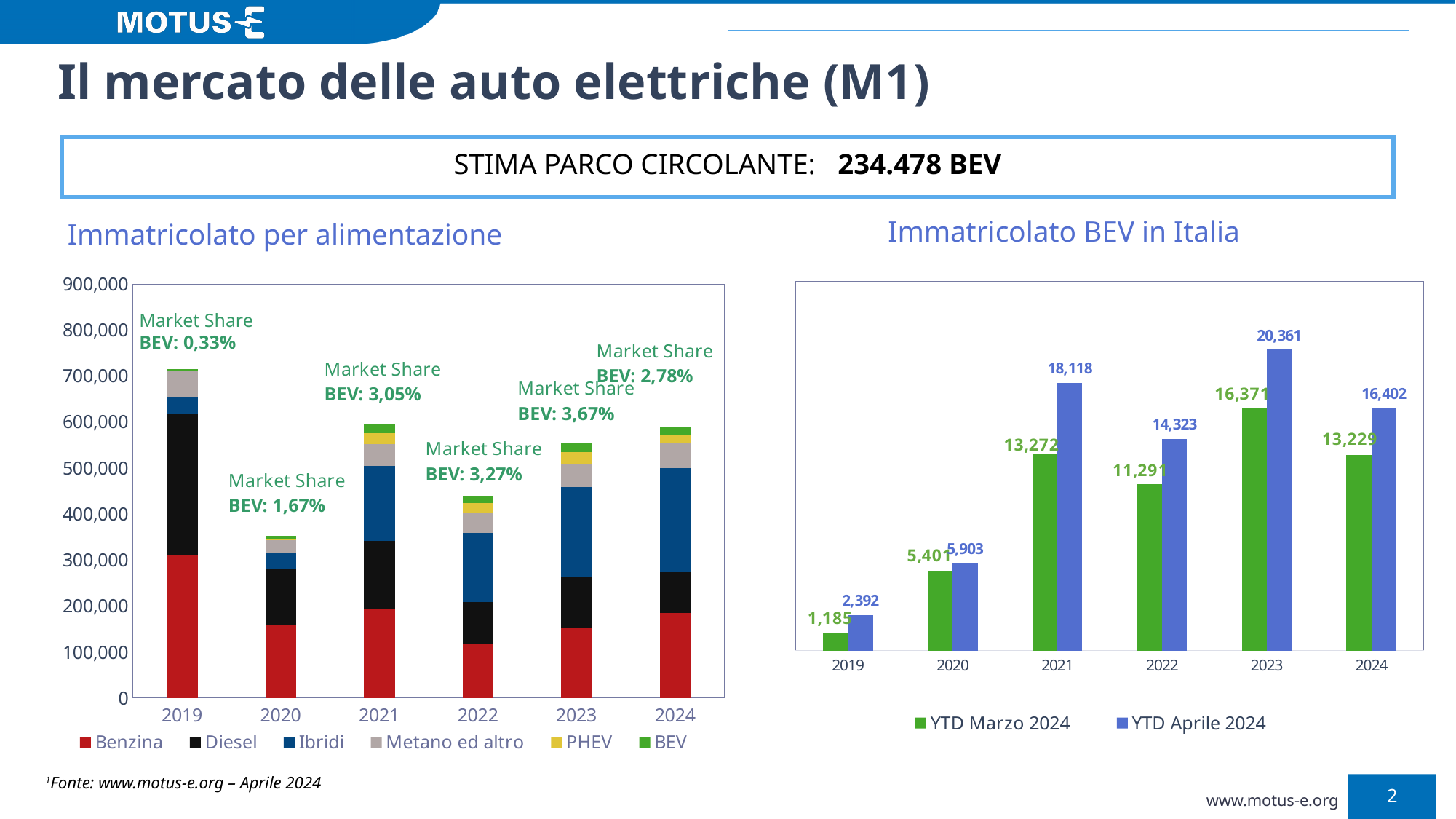
In the 'Immatricolato per alimentazione' chart, what is the BEV market share shown for 2023? 3,67% In the 'Immatricolato BEV in Italia' chart, which is larger: the YTD Aprile 2024 value for 2021 or for 2024? 2021 How many series does the legend of the 'Immatricolato per alimentazione' chart list? 6 In the 'Immatricolato BEV in Italia' chart, what is the difference between the YTD Aprile 2024 and YTD Marzo 2024 values for 2024? 3,173 In the 'Immatricolato BEV in Italia' chart, which year has the highest YTD Aprile 2024 value? 2023 In the 'Immatricolato BEV in Italia' chart, which year has the lowest YTD Marzo 2024 value? 2019 What kind of chart is 'Immatricolato per alimentazione'? Stacked bar chart In the 'Immatricolato per alimentazione' chart, is the total stacked value for 2019 greater or less than 600,000? greater In the 'Immatricolato BEV in Italia' chart, what is the YTD Aprile 2024 value for 2023? 20,361 In the 'Immatricolato BEV in Italia' chart, what is the YTD Marzo 2024 value for 2021? 13,272 How many series does the legend of the 'Immatricolato BEV in Italia' chart list? 2 In the 'Immatricolato per alimentazione' chart, what is the BEV market share shown for 2019? 0,33%